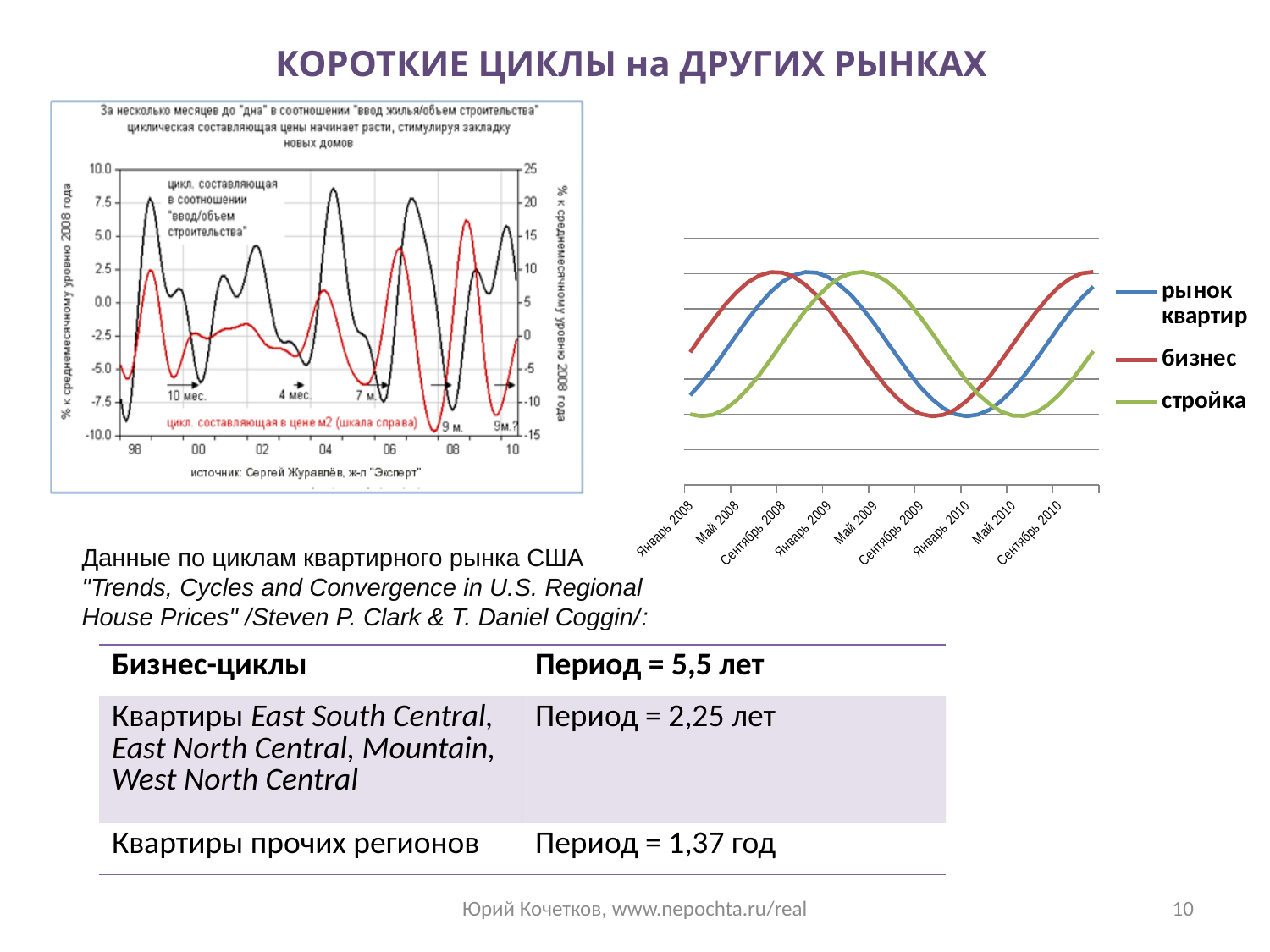
In the right-hand chart, which series is drawn in blue? рынок квартир How many series does the legend of the right-hand chart list? 3 In the right-hand chart, which series reaches its first peak earliest along the x axis? бизнес In the right-hand chart, does the бизнес series rise or fall between Сентябрь 2008 and Сентябрь 2009? fall In the right-hand chart, does the стройка series rise or fall between Январь 2008 and Май 2009? rise What kind of chart is the chart on the right side of the slide? line chart What kind of chart is the chart on the left side of the slide? line chart How many series are plotted in the left-hand chart? 2 How many date labels are shown on the x axis of the right-hand chart? 9 In the right-hand chart, does the рынок квартир series rise or fall between Январь 2010 and Сентябрь 2010? rise